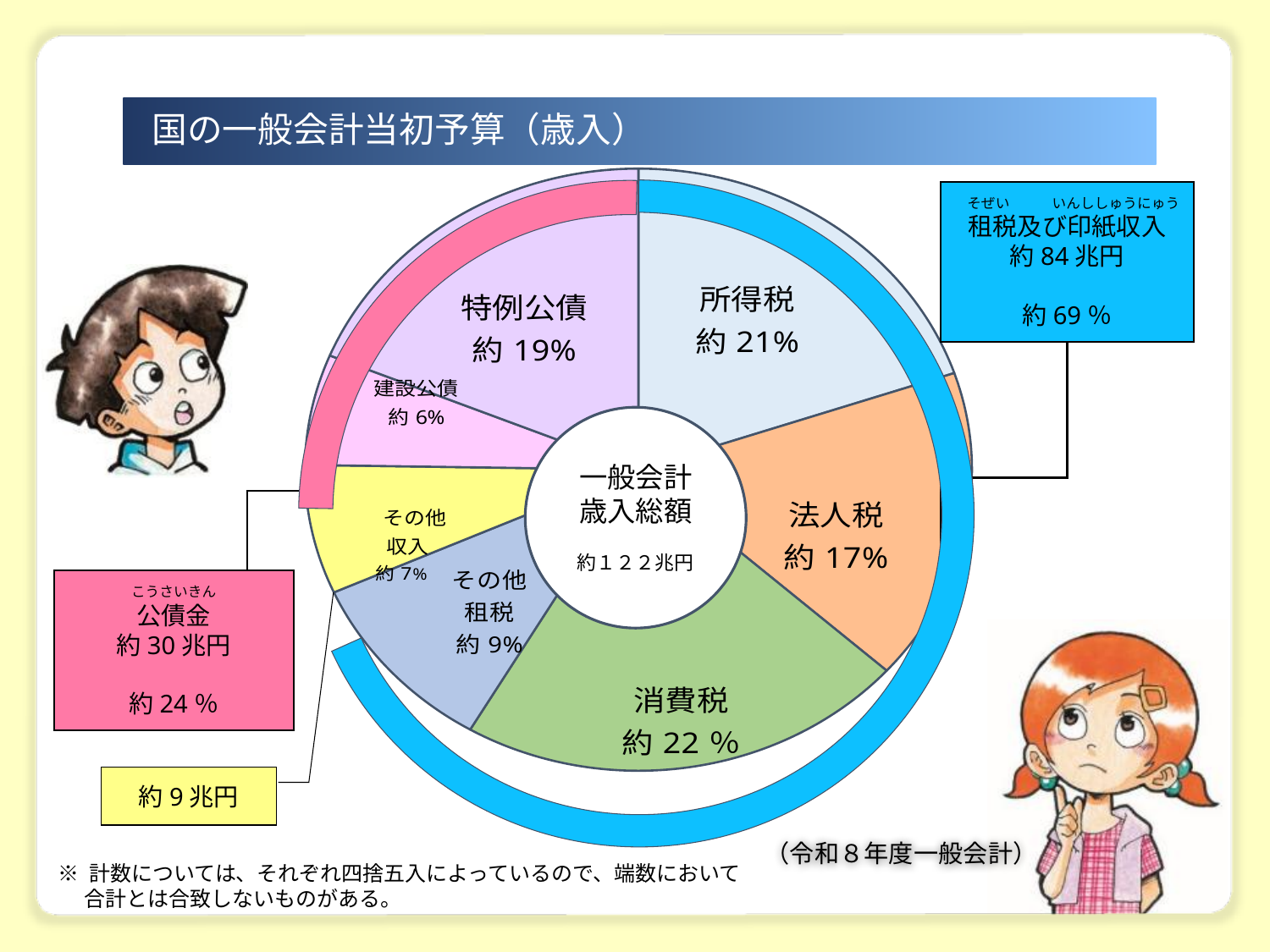
所得税と法人税では、どちらの割合が大きいですか？ 所得税 このスライドのグラフはどの種類のグラフですか？ 円グラフ 所得税の割合はいくらですか？ 約 21% 消費税の割合はいくらですか？ 約 22 % 建設公債の割合はいくらですか？ 約 6% 法人税の割合はいくらですか？ 約 17% 特例公債の割合はいくらですか？ 約 19% 公債金の割合はいくらですか？ 約 24 % 租税及び印紙収入の金額はいくらですか？ 約 84 兆円 円グラフには何個の項目（区分）がありますか？ 7 一般会計歳入総額はいくらですか？ 約１２２兆円 円グラフの中で最も割合が小さい項目はどれですか？ 建設公債